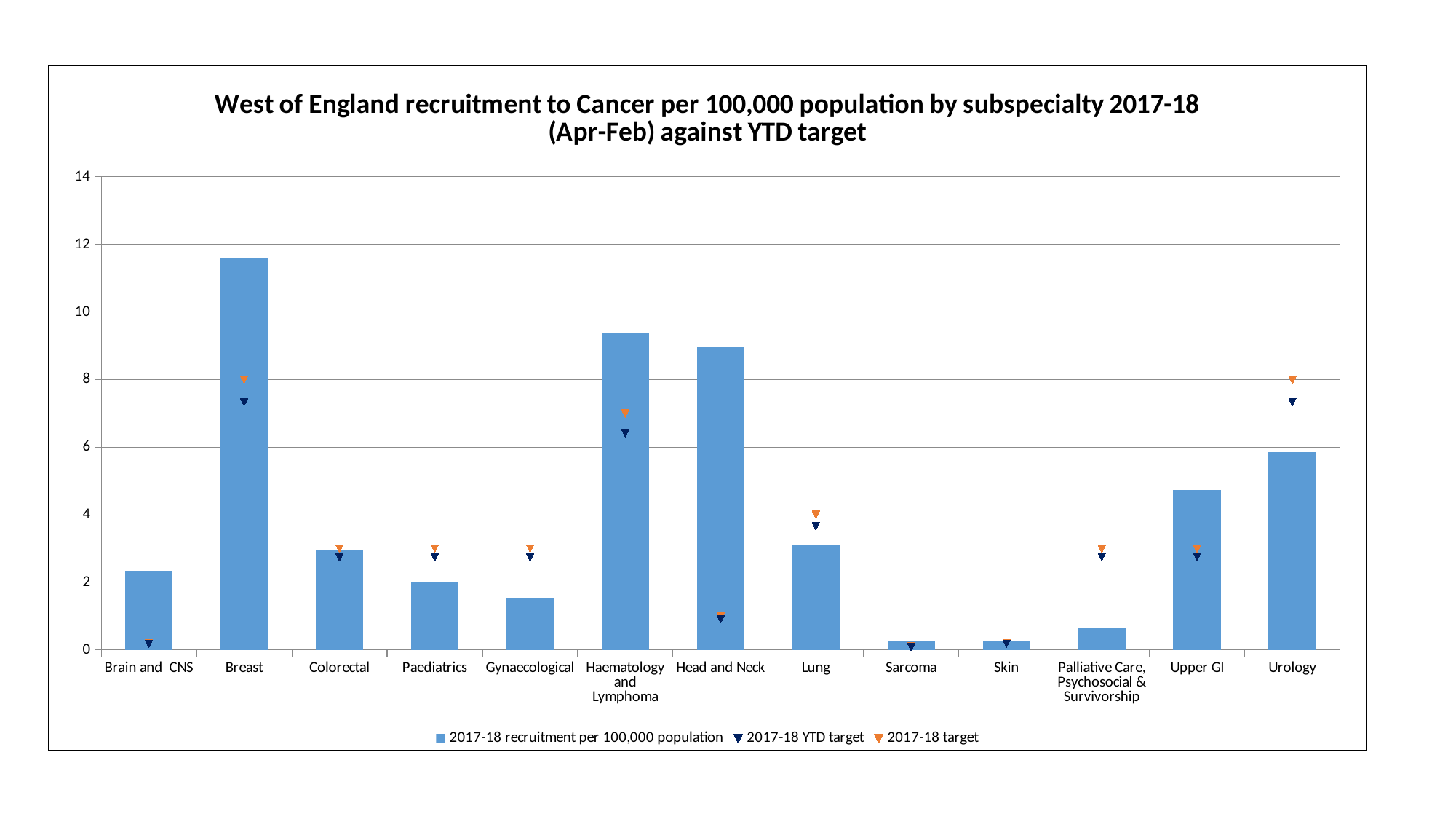
Is the 2017-18 recruitment per 100,000 population for Palliative Care, Psychosocial & Survivorship greater or less than 2? less Is the 2017-18 recruitment per 100,000 population for Lung greater or less than 4? less Is the 2017-18 recruitment per 100,000 population for Gynaecological greater or less than 2? less Which subspecialty has the highest 2017-18 recruitment per 100,000 population? Breast What kind of chart is shown on the slide? bar chart Which has the higher 2017-18 recruitment per 100,000 population, Upper GI or Lung? Upper GI How many series does the legend list? 3 Which has the higher 2017-18 recruitment per 100,000 population, Breast or Haematology and Lymphoma? Breast What colour marker does the legend use for the 2017-18 target series? orange How many subspecialty categories are shown on the x axis? 13